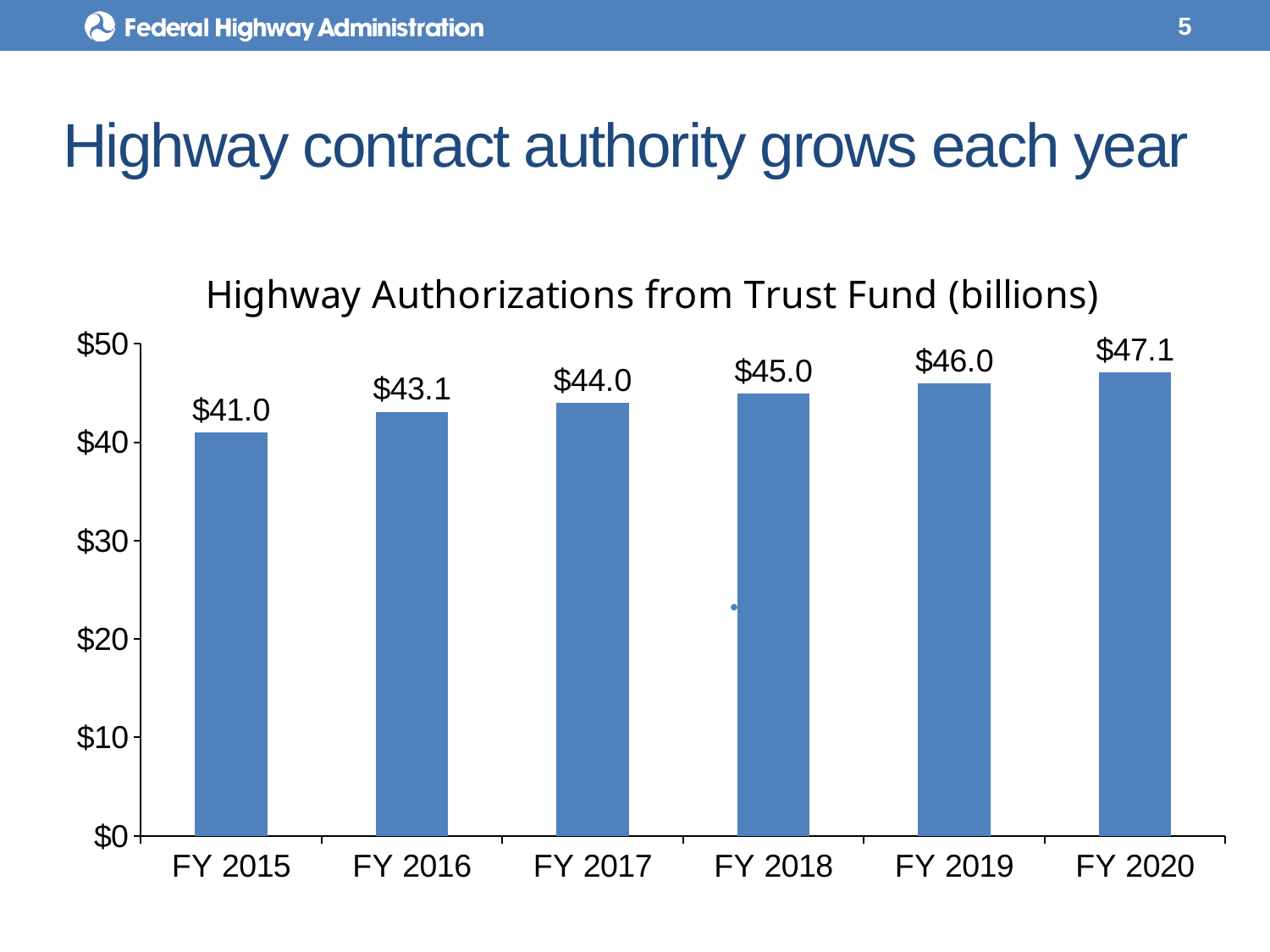
Is the value for FY 2016 greater or less than $40? greater What is the difference between the FY 2016 and FY 2015 values? $2.1 What is the value for FY 2020? $47.1 How many fiscal years are shown on the chart? 6 What is the value for FY 2018? $45.0 Which fiscal year has the highest authorization? FY 2020 Do the values rise or fall from FY 2015 to FY 2020? Rise What is the value for FY 2015? $41.0 Which is larger, the value for FY 2017 or FY 2019? FY 2019 What is the difference between the FY 2020 and FY 2015 values? $6.1 What kind of chart is shown on the slide? Bar chart Which fiscal year has the lowest authorization? FY 2015